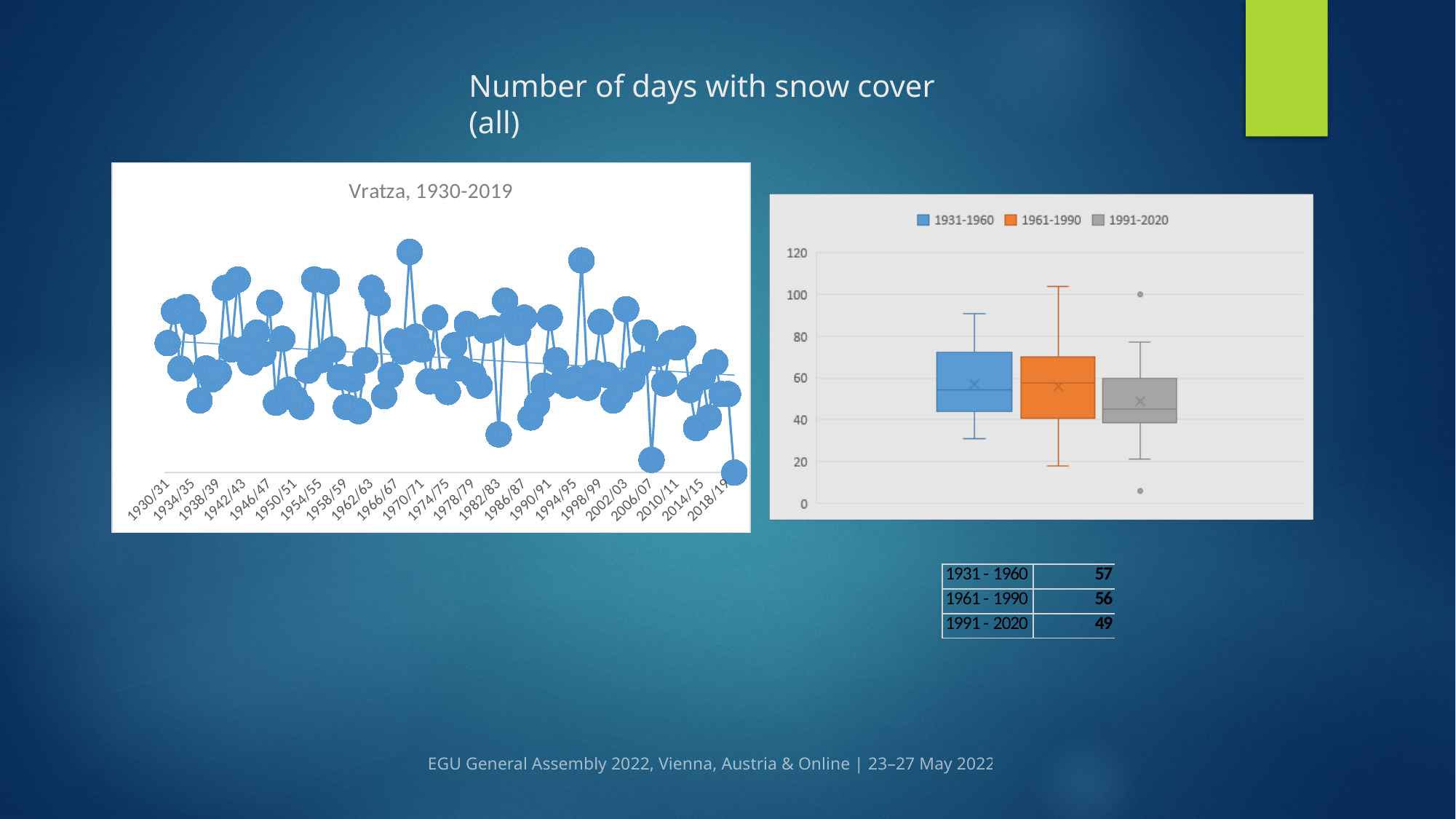
In the right box plot chart, is the top of the upper whisker for 1991-2020 greater or less than 80? less In the right box plot chart, is the top of the upper whisker for 1931-1960 greater or less than 80? greater In the right box plot chart, which period has the lowest mean number of days with snow cover according to the table below it? 1991 - 2020 In the left chart "Vratza, 1930-2019", do the values generally rise or fall along the x axis according to the trend line? fall According to the table under the right box plot chart, what is the mean number of days with snow cover for 1961 - 1990? 56 What kind of chart is the left chart titled "Vratza, 1930-2019"? line chart How many series does the legend of the right box plot chart list? 3 According to the table under the right box plot chart, what is the difference between the mean for 1931 - 1960 and the mean for 1991 - 2020? 8 In the right box plot chart, is the top of the upper whisker for 1961-1990 greater or less than 100? greater In the right box plot chart, which colour represents the 1961-1990 series? orange What kind of chart is the right chart with the 1931-1960, 1961-1990 and 1991-2020 legend? box plot In the right box plot chart, which period has the highest mean number of days with snow cover according to the table below it? 1931 - 1960